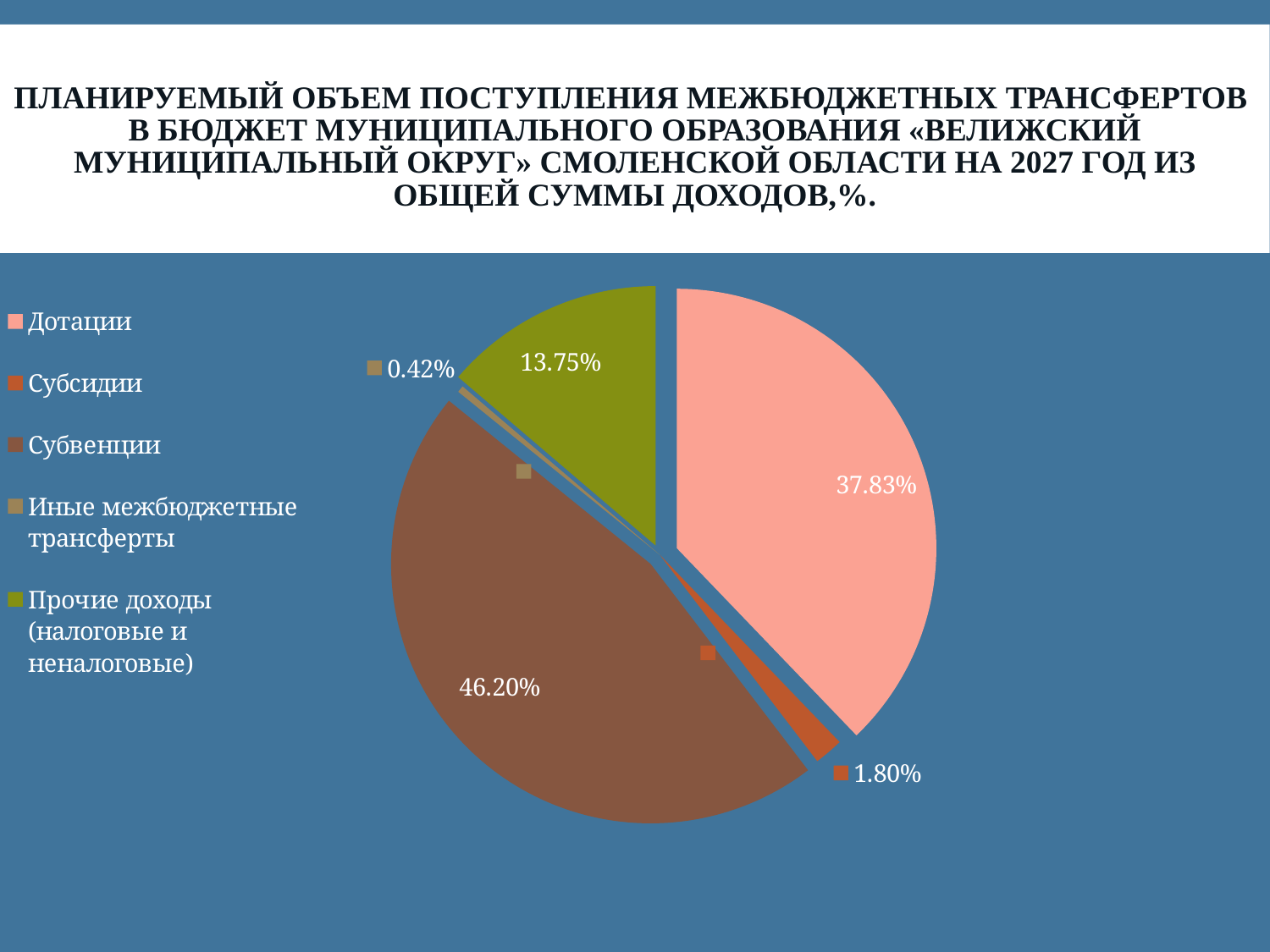
What share of the pie does Субсидии have? 1.80% What is the difference in percentage points between Субвенции and Дотации? 8.37 What share of the pie does Дотации have? 37.83% Which category has the largest slice of the pie? Субвенции What share of the pie does Иные межбюджетные трансферты have? 0.42% Which category has the smallest slice of the pie? Иные межбюджетные трансферты Which is larger, the slice for Дотации or the slice for Прочие доходы (налоговые и неналоговые)? Дотации What kind of chart is shown on the slide? pie chart What colour is the slice for Субвенции? brown How many categories does the pie chart have? 5 What share of the pie does Субвенции have? 46.20% What share of the pie does Прочие доходы (налоговые и неналоговые) have? 13.75%